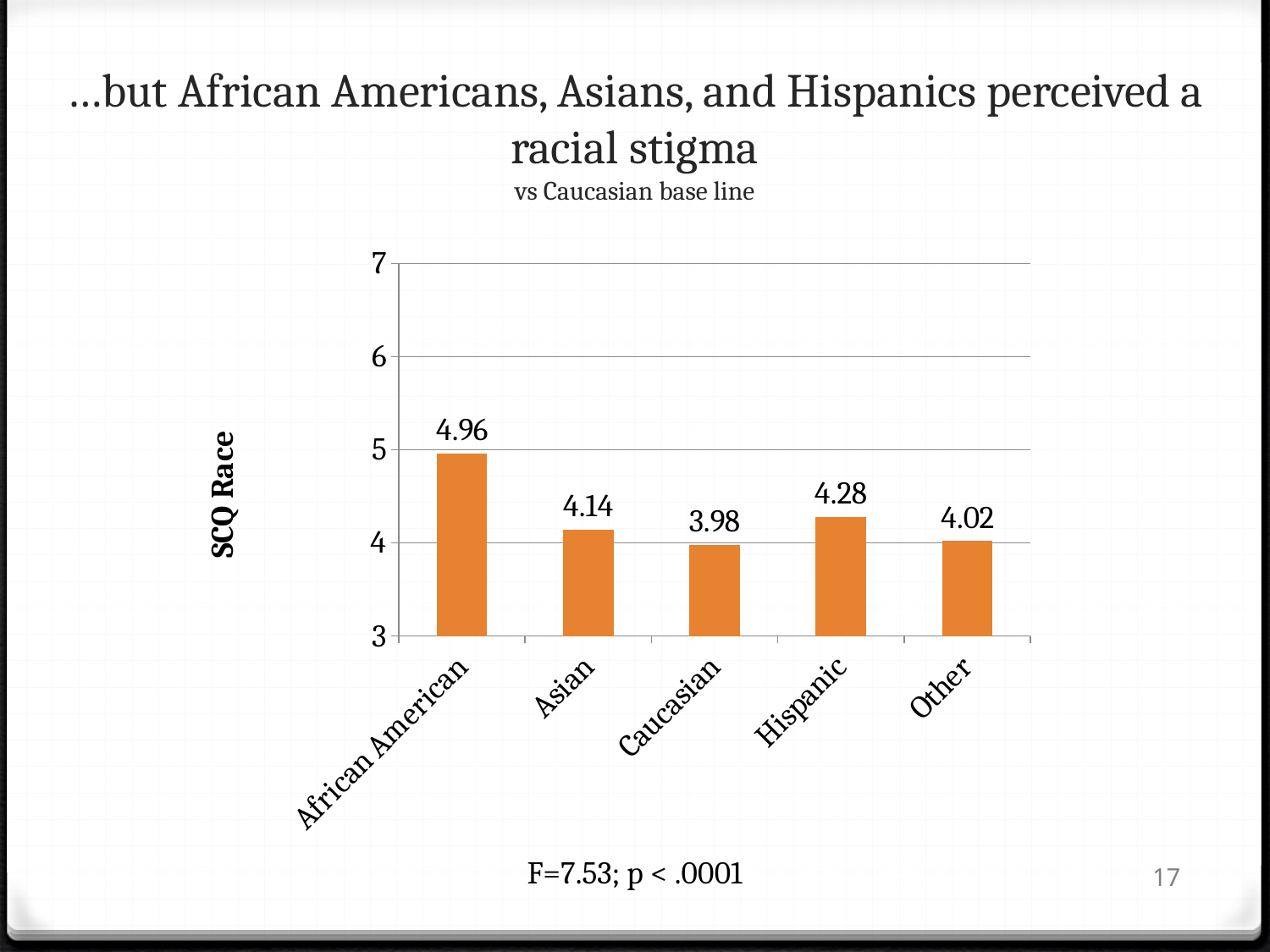
What is the difference between the SCQ Race values for Hispanic and Asian? 0.14 What is the SCQ Race value for Caucasian? 3.98 What is the SCQ Race value for African American? 4.96 Which has a larger SCQ Race value, Asian or Hispanic? Hispanic What kind of chart is shown on the slide? Bar chart Which category has the highest SCQ Race value? African American What is the label of the vertical axis? SCQ Race What is the difference between the SCQ Race values for African American and Caucasian? 0.98 How many categories are shown on the x axis? 5 Which category has the lowest SCQ Race value? Caucasian What is the SCQ Race value for Hispanic? 4.28 What is the SCQ Race value for Other? 4.02